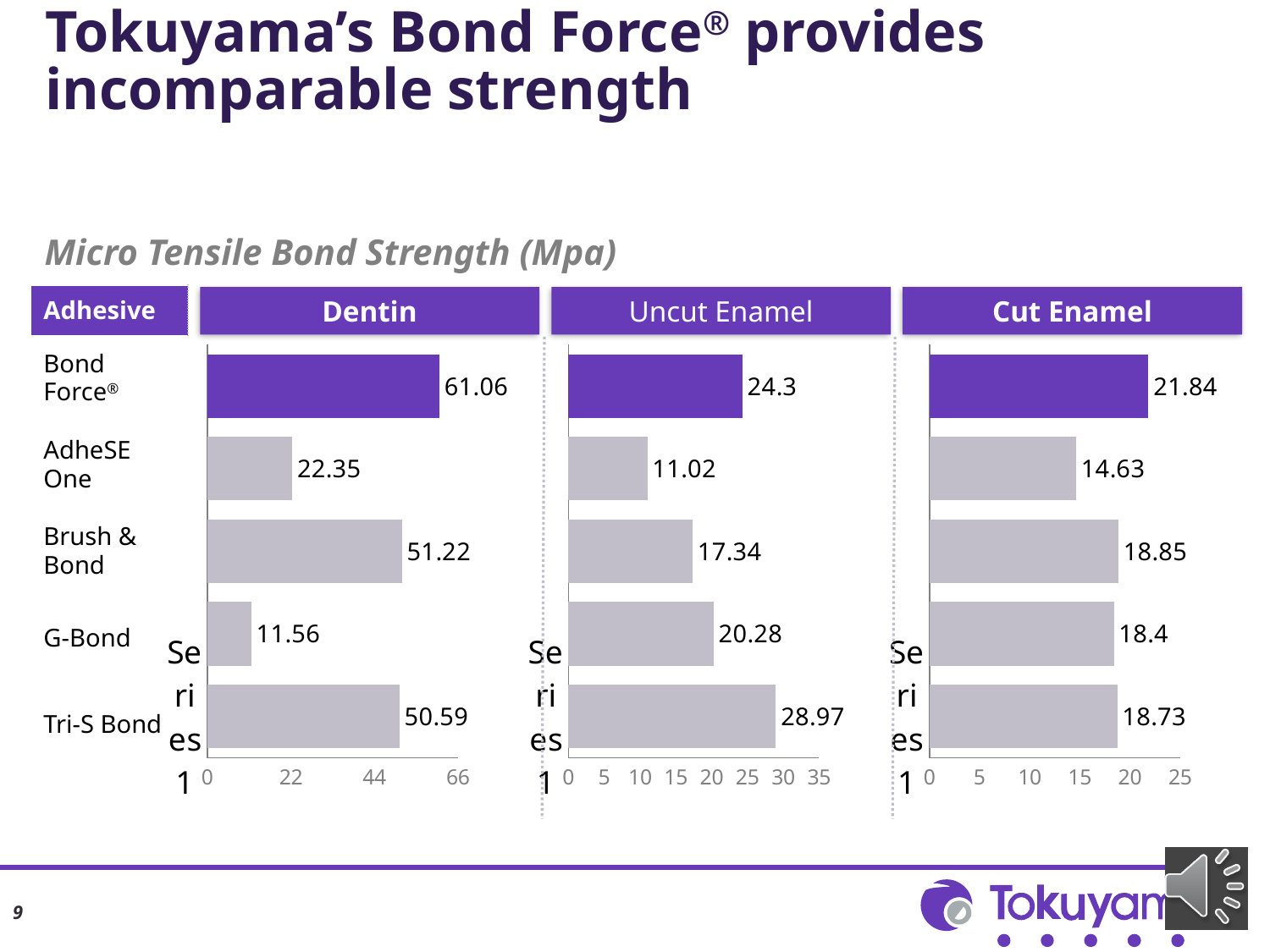
In the Cut Enamel chart, which adhesive has the highest value? Bond Force How many adhesives are plotted in the Dentin chart? 5 In the Cut Enamel chart, what is the value for AdheSE One? 14.63 What kind of chart is the Uncut Enamel chart? Bar chart In the Uncut Enamel chart, what is the value for Tri-S Bond? 28.97 In the Dentin chart, what is the value for Bond Force? 61.06 In the Dentin chart, is the value for Tri-S Bond greater or less than 44? greater In the Dentin chart, which adhesive has the lowest value? G-Bond In the Dentin chart, what is the difference between the values for Bond Force and AdheSE One? 38.71 In the Cut Enamel chart, what is the difference between the values for Bond Force and Brush & Bond? 2.99 In the Uncut Enamel chart, which is larger, the value for G-Bond or the value for Brush & Bond? G-Bond In the Uncut Enamel chart, which adhesive has the highest value? Tri-S Bond